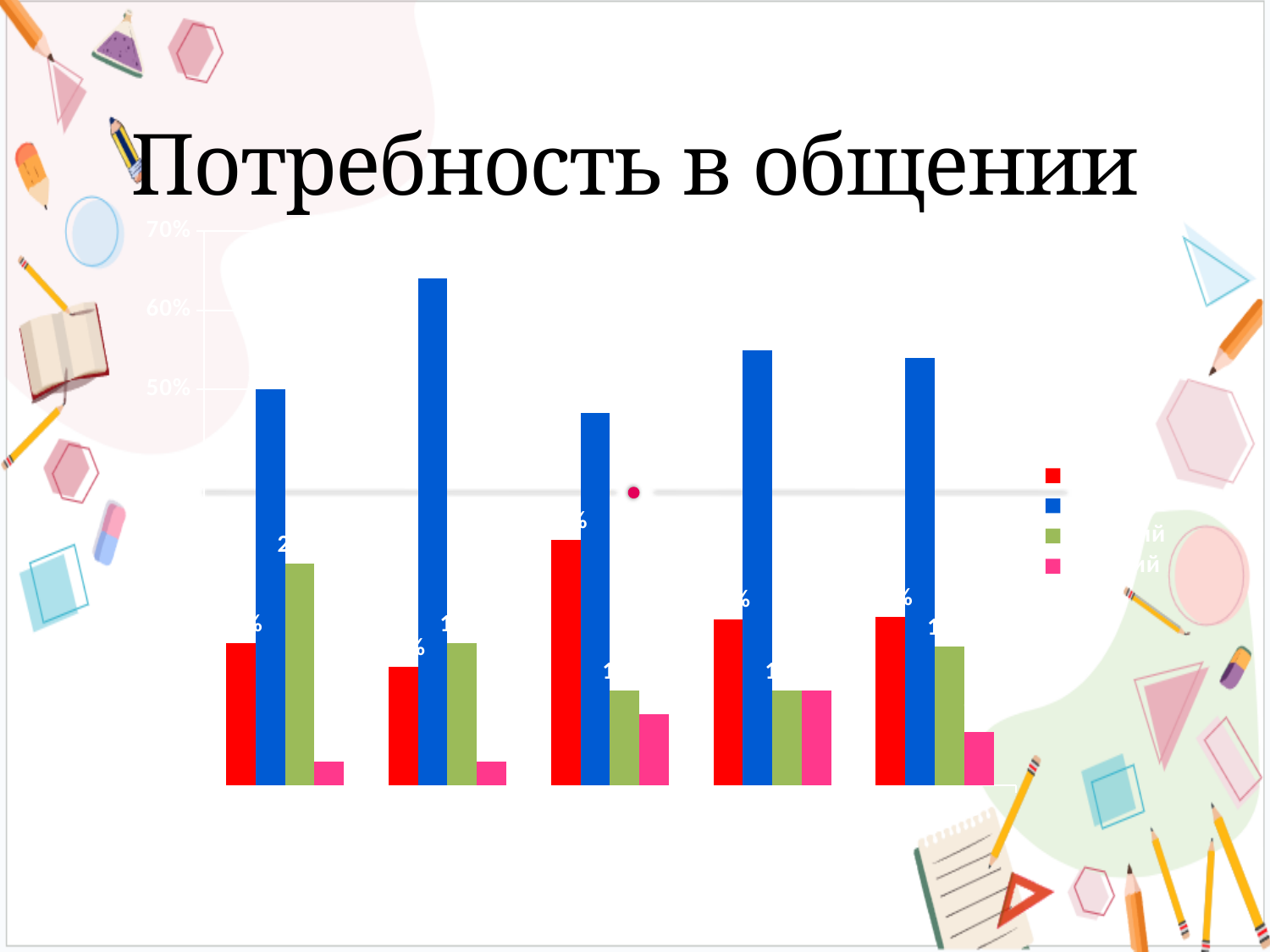
What kind of chart is shown on the slide? bar chart Is the blue bar in the second category group from the left greater or less than 60%? greater Which coloured series has the shortest bar in the first (leftmost) category group? pink In which category group from the left is the blue bar the tallest across the whole chart? second Which coloured series has the tallest bar in every category group? blue In the second category group from the left, which is taller: the blue bar or the green bar? blue What is the title of the chart on the slide? Потребность в общении Is the red bar in the first (leftmost) category group greater or less than 50%? less How many series does the legend of the chart list? 4 How many groups of bars (categories) are plotted in the chart? 5 Is the blue bar in the third category group from the left greater or less than 50%? less